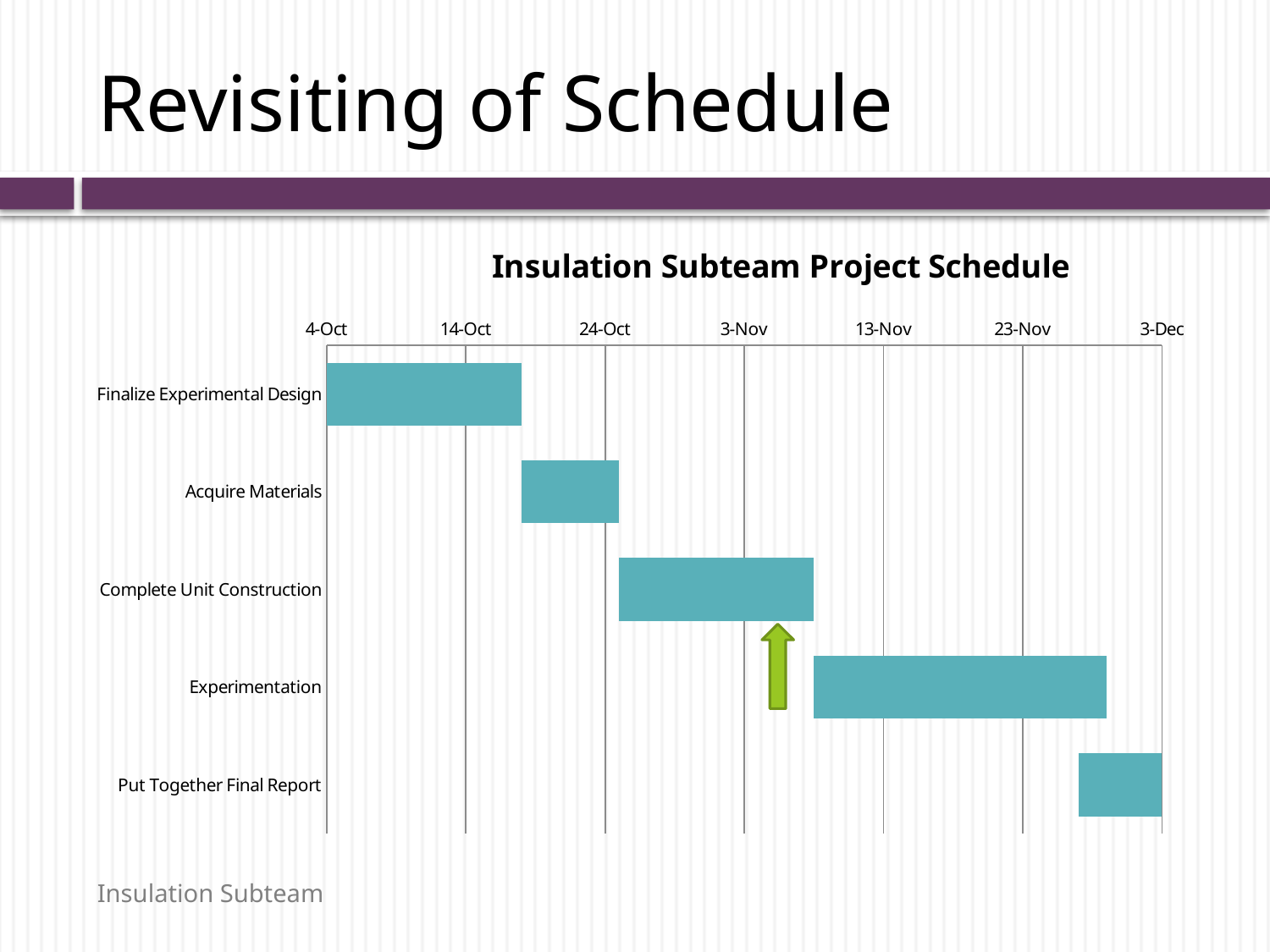
Does the Complete Unit Construction task end before or after 13-Nov? before What kind of chart is shown on the slide? Bar chart (Gantt chart) What is the title of the chart? Insulation Subteam Project Schedule Does the Experimentation task start before or after 3-Nov? after How many tasks are listed on the vertical axis of the chart? 5 Which task has a longer bar, Complete Unit Construction or Acquire Materials? Complete Unit Construction On what date does the Finalize Experimental Design task begin? 4-Oct Does the Finalize Experimental Design task end before or after 24-Oct? before Which task has the longest bar in the schedule? Experimentation How many date labels are shown along the horizontal axis? 7 Which task is scheduled first in the chart? Finalize Experimental Design